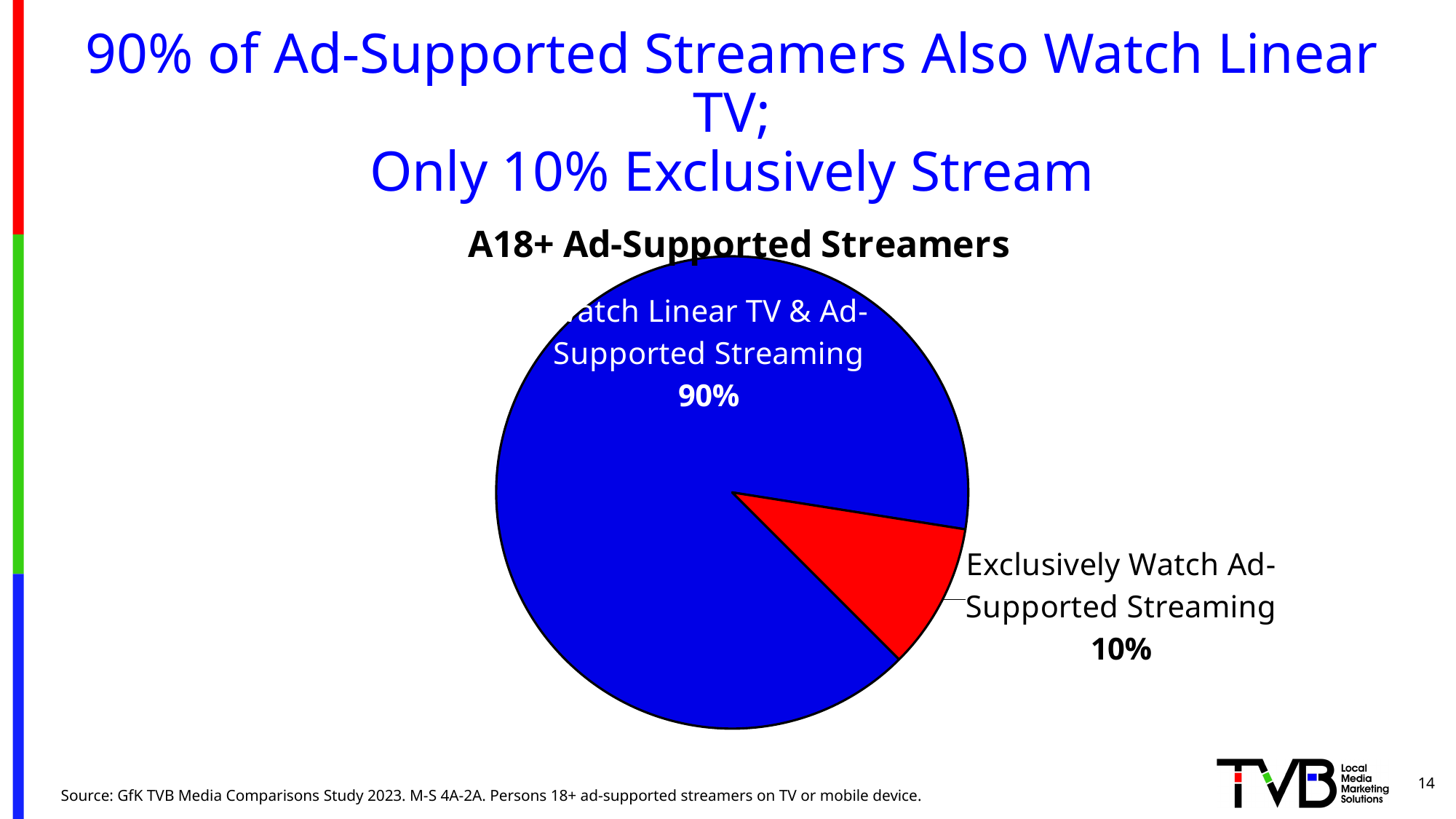
What share of the pie does the 'Exclusively Watch Ad-Supported Streaming' slice represent? 10% Which is larger: the share that watches linear TV & ad-supported streaming, or the share that exclusively watches ad-supported streaming? Watch Linear TV & Ad-Supported Streaming Which slice of the pie is the smallest? Exclusively Watch Ad-Supported Streaming What percentage of A18+ ad-supported streamers watch linear TV & ad-supported streaming? 90% How many slices does the pie chart have? 2 What percentage of A18+ ad-supported streamers exclusively watch ad-supported streaming? 10% Which slice of the pie is the largest? Watch Linear TV & Ad-Supported Streaming What is the difference in percentage points between the 'Watch Linear TV & Ad-Supported Streaming' slice and the 'Exclusively Watch Ad-Supported Streaming' slice? 80 percentage points What kind of chart is shown on the slide? pie chart What is the title of the chart? A18+ Ad-Supported Streamers What colour is the 'Exclusively Watch Ad-Supported Streaming' slice? red